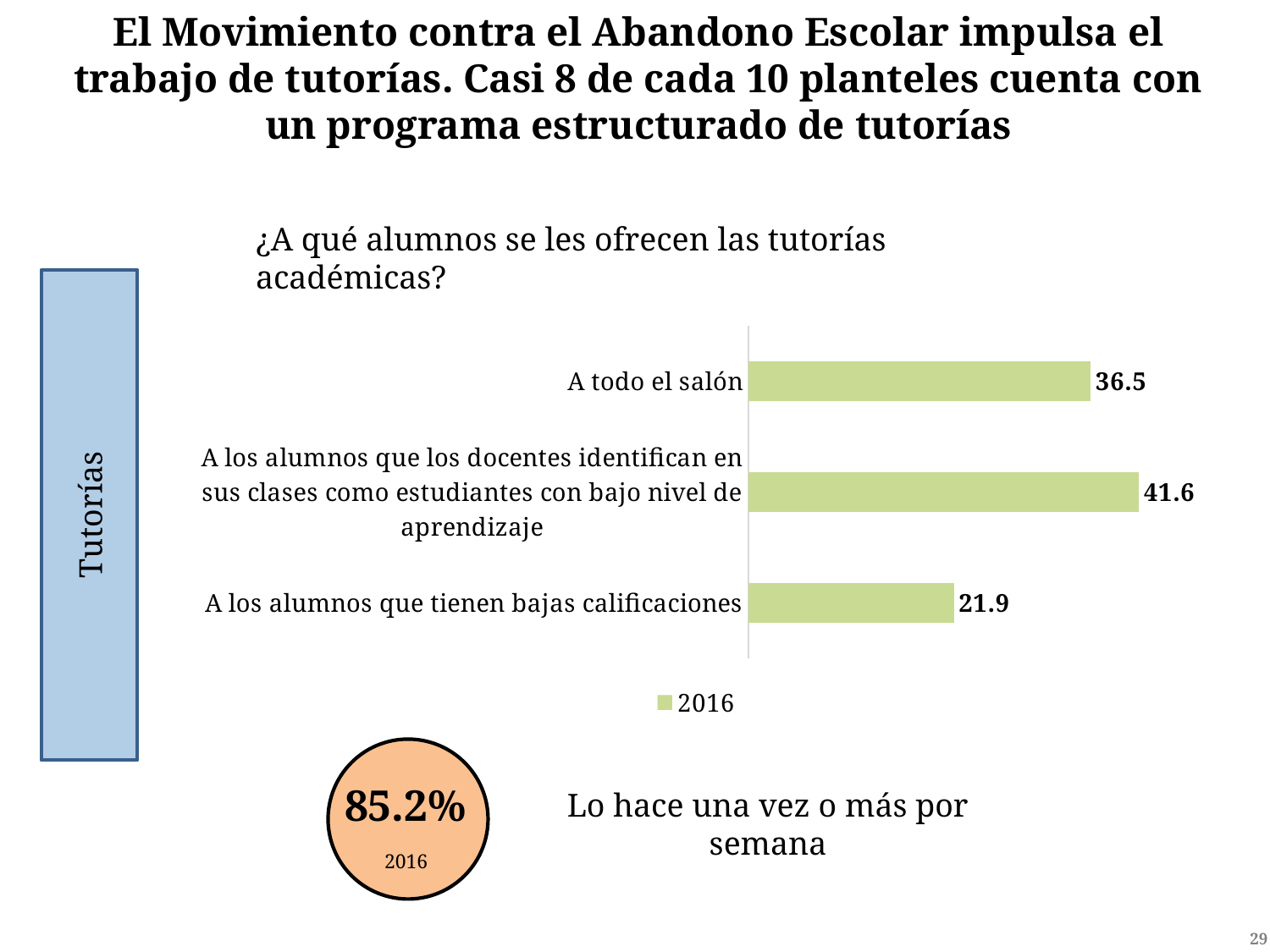
What year does the legend entry of the chart show? 2016 What is the value for "A los alumnos que los docentes identifican en sus clases como estudiantes con bajo nivel de aprendizaje"? 41.6 What is the difference between the values for "A todo el salón" and "A los alumnos que tienen bajas calificaciones"? 14.6 How many series does the legend list? 1 What kind of chart is shown on the slide? Bar chart How many categories does the chart show? 3 What is the difference between the values for "A los alumnos que los docentes identifican en sus clases como estudiantes con bajo nivel de aprendizaje" and "A todo el salón"? 5.1 What is the value for "A los alumnos que tienen bajas calificaciones"? 21.9 Which category has the highest value? A los alumnos que los docentes identifican en sus clases como estudiantes con bajo nivel de aprendizaje Which is larger: the value for "A todo el salón" or the value for "A los alumnos que tienen bajas calificaciones"? A todo el salón What is the value for "A todo el salón"? 36.5 Which category has the lowest value? A los alumnos que tienen bajas calificaciones